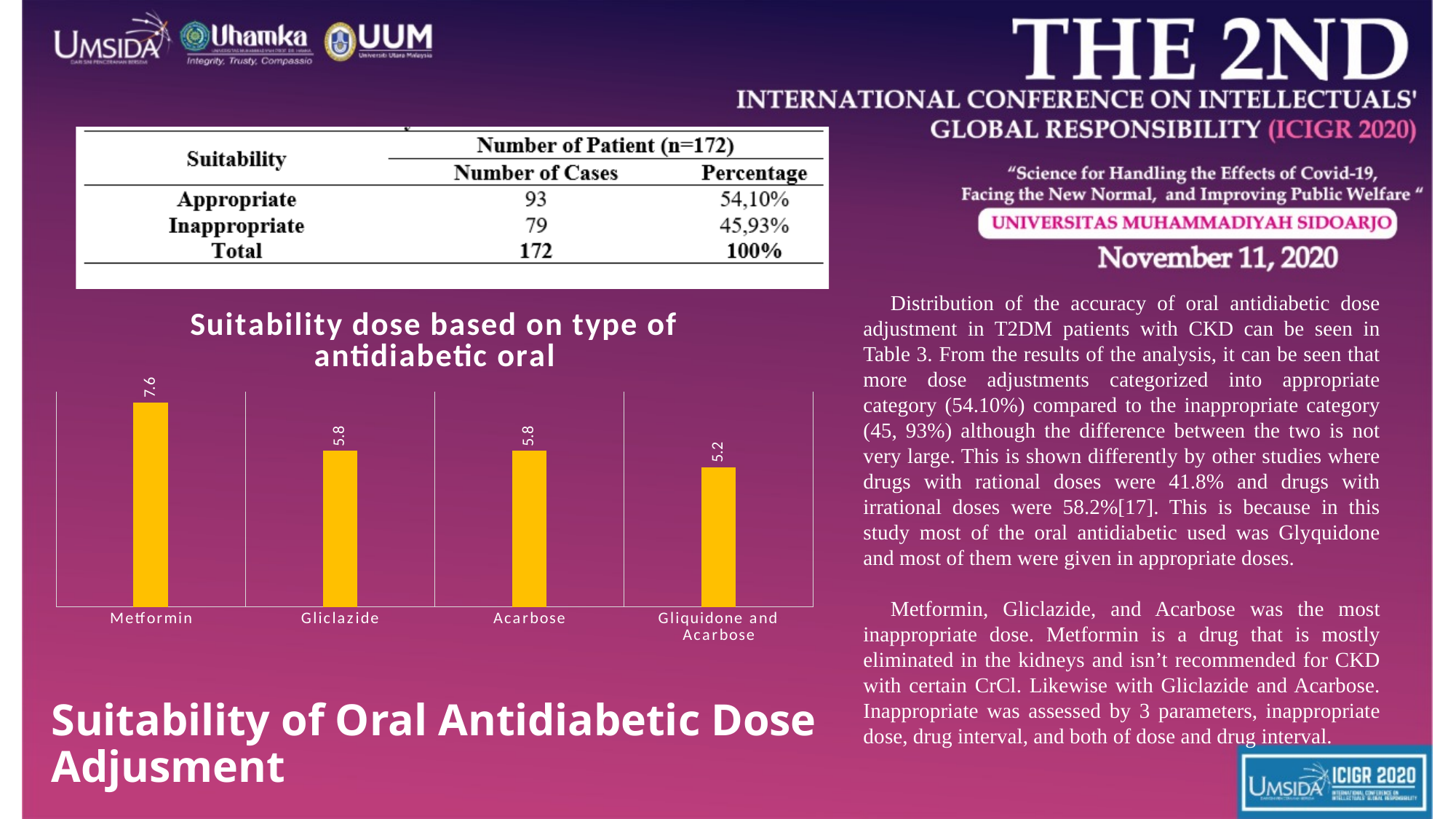
What is the value for Acarbose in the chart? 5.8 Which category has the lowest value in the chart? Gliquidone and Acarbose What is the value for Metformin in the chart? 7.6 What is the difference between the values for Metformin and Gliquidone and Acarbose? 2.4 Which category has the highest value in the chart? Metformin How many categories are shown in the chart? 4 What is the value for Gliclazide in the chart? 5.8 Which is larger, the value for Metformin or the value for Acarbose? Metformin What is the difference between the values for Metformin and Gliclazide? 1.8 What is the value for Gliquidone and Acarbose in the chart? 5.2 What kind of chart is shown on the slide? Bar chart What is the title of the chart? Suitability dose based on type of antidiabetic oral